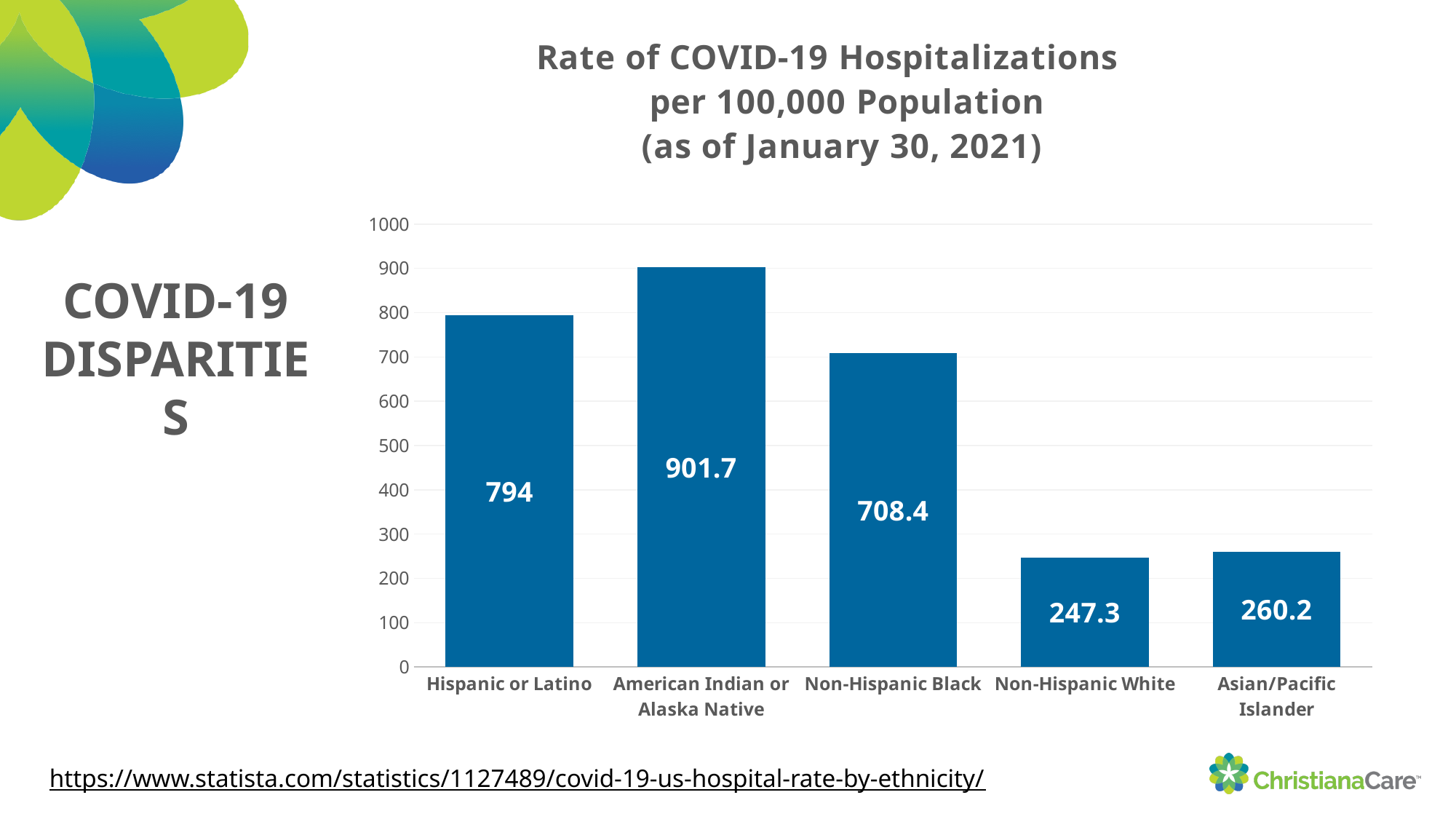
How many groups are shown in the chart? 5 What is the difference between the hospitalization rates for Hispanic or Latino and Non-Hispanic White? 546.7 What is the difference between the hospitalization rates for American Indian or Alaska Native and Non-Hispanic Black? 193.3 Which has a higher hospitalization rate, Hispanic or Latino or Non-Hispanic Black? Hispanic or Latino What kind of chart is shown on the slide? Bar chart What is the rate of COVID-19 hospitalizations per 100,000 population for Hispanic or Latino? 794 Which group has the lowest rate of COVID-19 hospitalizations? Non-Hispanic White What is the rate of COVID-19 hospitalizations per 100,000 population for Asian/Pacific Islander? 260.2 Which group has the highest rate of COVID-19 hospitalizations? American Indian or Alaska Native What is the rate of COVID-19 hospitalizations per 100,000 population for American Indian or Alaska Native? 901.7 As of what date is the data in the chart title reported? January 30, 2021 What is the rate of COVID-19 hospitalizations per 100,000 population for Non-Hispanic White? 247.3